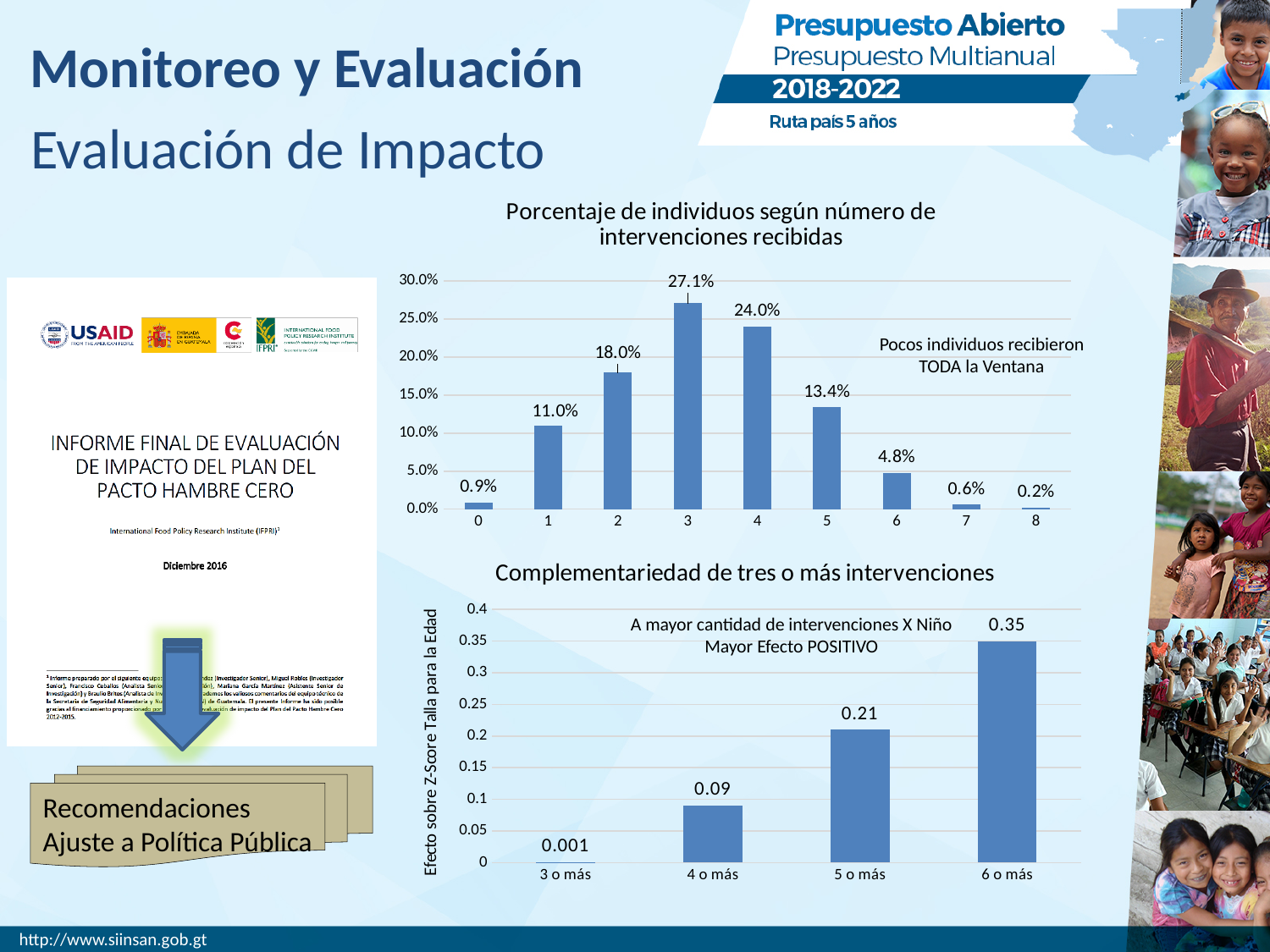
In the chart 'Porcentaje de individuos según número de intervenciones recibidas', what is the difference between the values for categories 4 and 5? 10.6% In the chart 'Porcentaje de individuos según número de intervenciones recibidas', which category has the highest value? 3 In the chart 'Porcentaje de individuos según número de intervenciones recibidas', what is the value for category 3? 27.1% In the chart 'Complementariedad de tres o más intervenciones', do the values rise or fall from left to right along the x axis? rise In the chart 'Complementariedad de tres o más intervenciones', which category has the highest value? 6 o más What kind of chart is 'Complementariedad de tres o más intervenciones'? bar chart In the chart 'Complementariedad de tres o más intervenciones', what is the value for '5 o más'? 0.21 In the chart 'Porcentaje de individuos según número de intervenciones recibidas', how many categories are shown on the x axis? 9 In the chart 'Porcentaje de individuos según número de intervenciones recibidas', which category has the lowest value? 8 In the chart 'Complementariedad de tres o más intervenciones', what is the difference between the values for '6 o más' and '4 o más'? 0.26 In the chart 'Porcentaje de individuos según número de intervenciones recibidas', is the value for category 2 greater or less than 15.0%? greater In the chart 'Porcentaje de individuos según número de intervenciones recibidas', what is the value for category 0? 0.9%